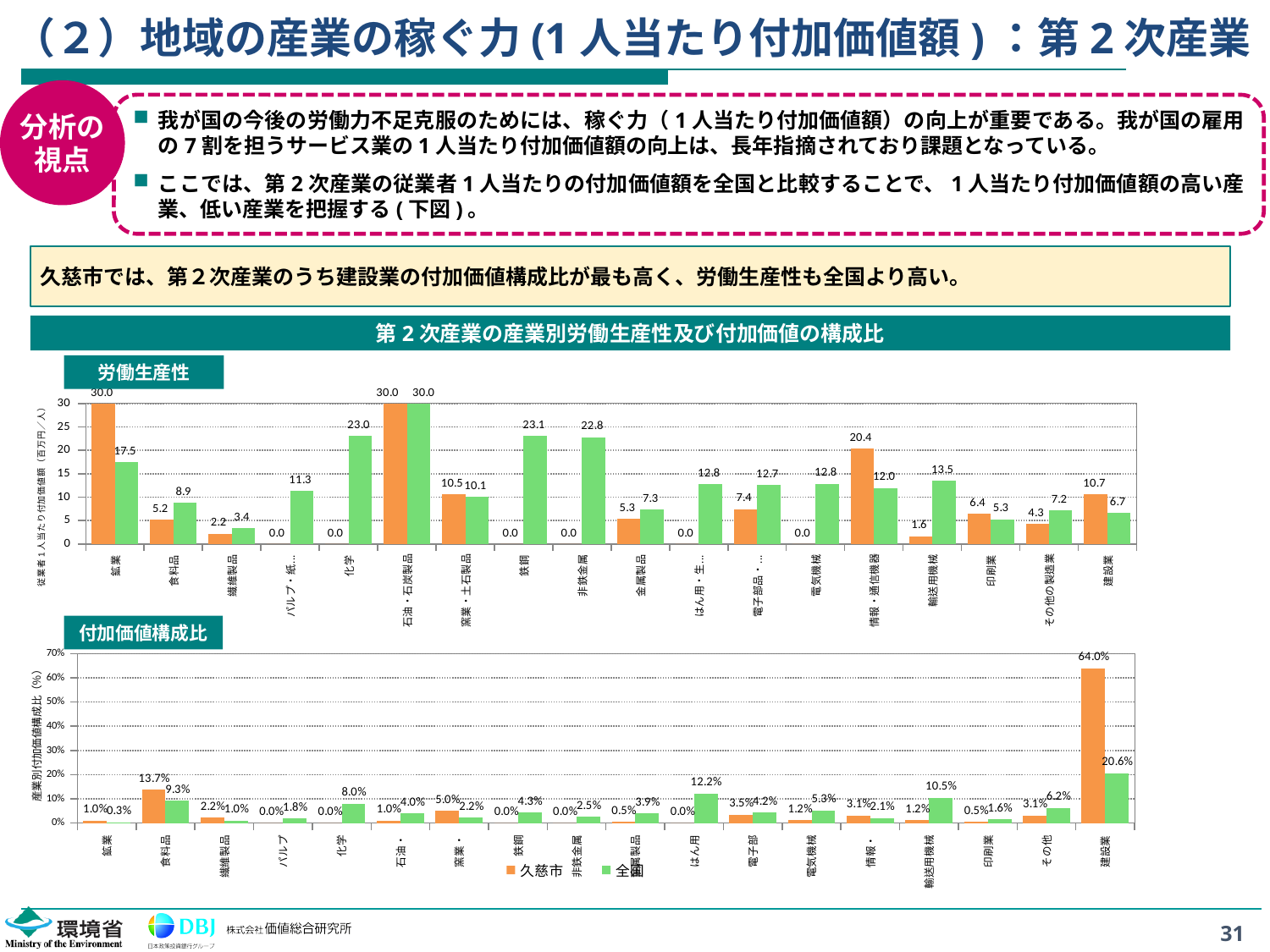
In the 労働生産性 chart, which is larger for 食料品, 久慈市 or 全国? 全国 In the 付加価値構成比 chart, what is the value for 全国 in 輸送用機械? 10.5% How many series does the legend of the 付加価値構成比 chart list? 2 In the 付加価値構成比 chart, what is the value for 久慈市 in 建設業? 64.0% What type of chart is the 労働生産性 chart? Bar chart In the 労働生産性 chart, which category has the highest 全国 value? 石油・石炭製品 In the 付加価値構成比 chart, which is larger for はん用, 久慈市 or 全国? 全国 In the 付加価値構成比 chart, which category has the highest 久慈市 value? 建設業 In the 付加価値構成比 chart, what is the difference between 久慈市 and 全国 in 食料品? 4.4% In the 労働生産性 chart, what is the difference between 久慈市 and 全国 in 情報・通信機器? 8.4 In the 労働生産性 chart, what is the value for 久慈市 in 建設業? 10.7 In the 労働生産性 chart, what is the value for 全国 in 化学? 23.0